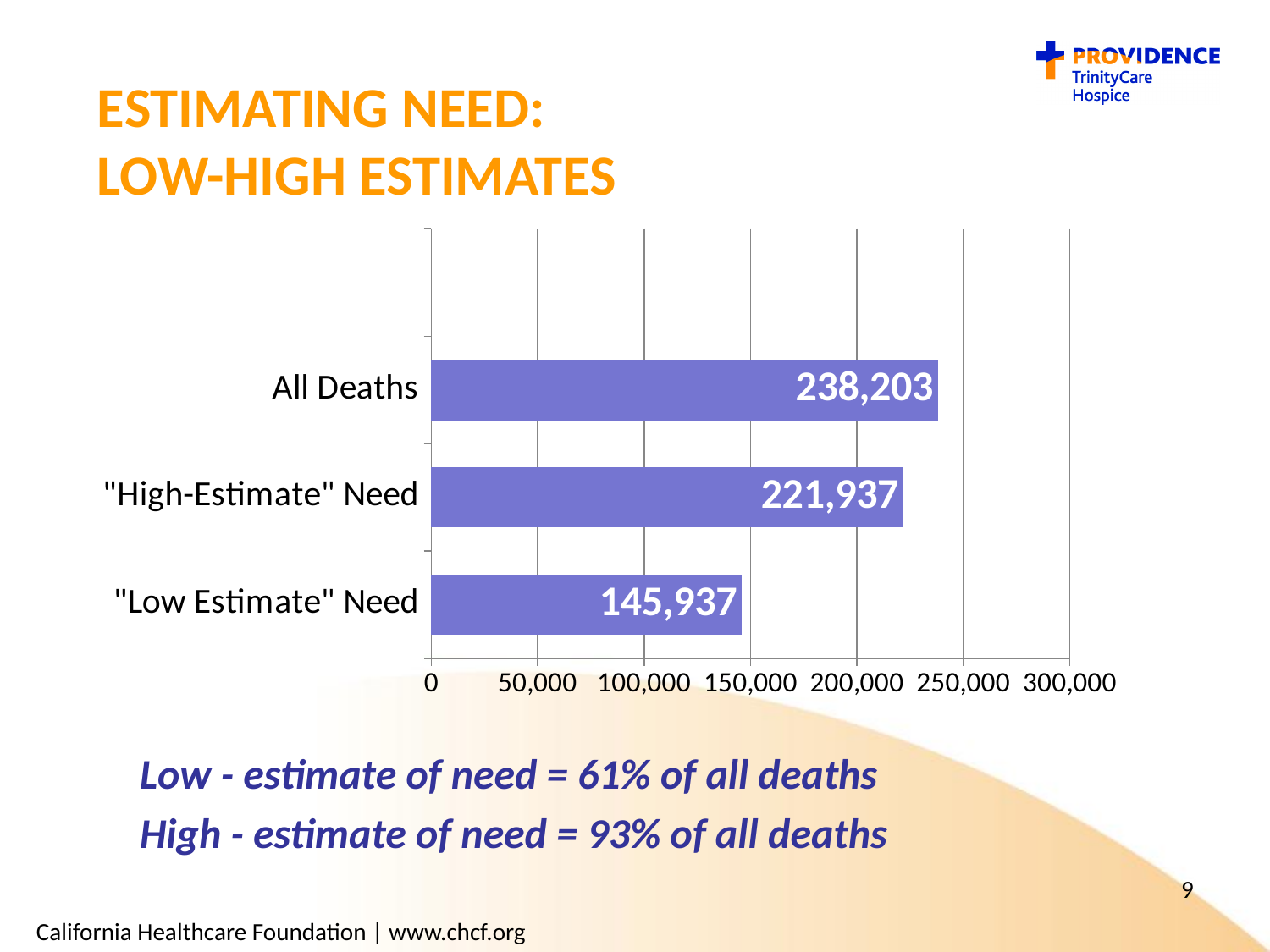
What is the difference between All Deaths and "High-Estimate" Need? 16,266 What is the difference between "High-Estimate" Need and "Low Estimate" Need? 76,000 Which is larger, "High-Estimate" Need or "Low Estimate" Need? "High-Estimate" Need Which category has the highest value? All Deaths Is the value for "Low Estimate" Need greater or less than 150,000? less What is the value for "High-Estimate" Need? 221,937 What is the highest value shown on the x axis? 300,000 What kind of chart is shown on the slide? bar chart What is the value for "Low Estimate" Need? 145,937 What is the value for All Deaths? 238,203 Which category has the lowest value? "Low Estimate" Need How many categories are shown in the chart? 3